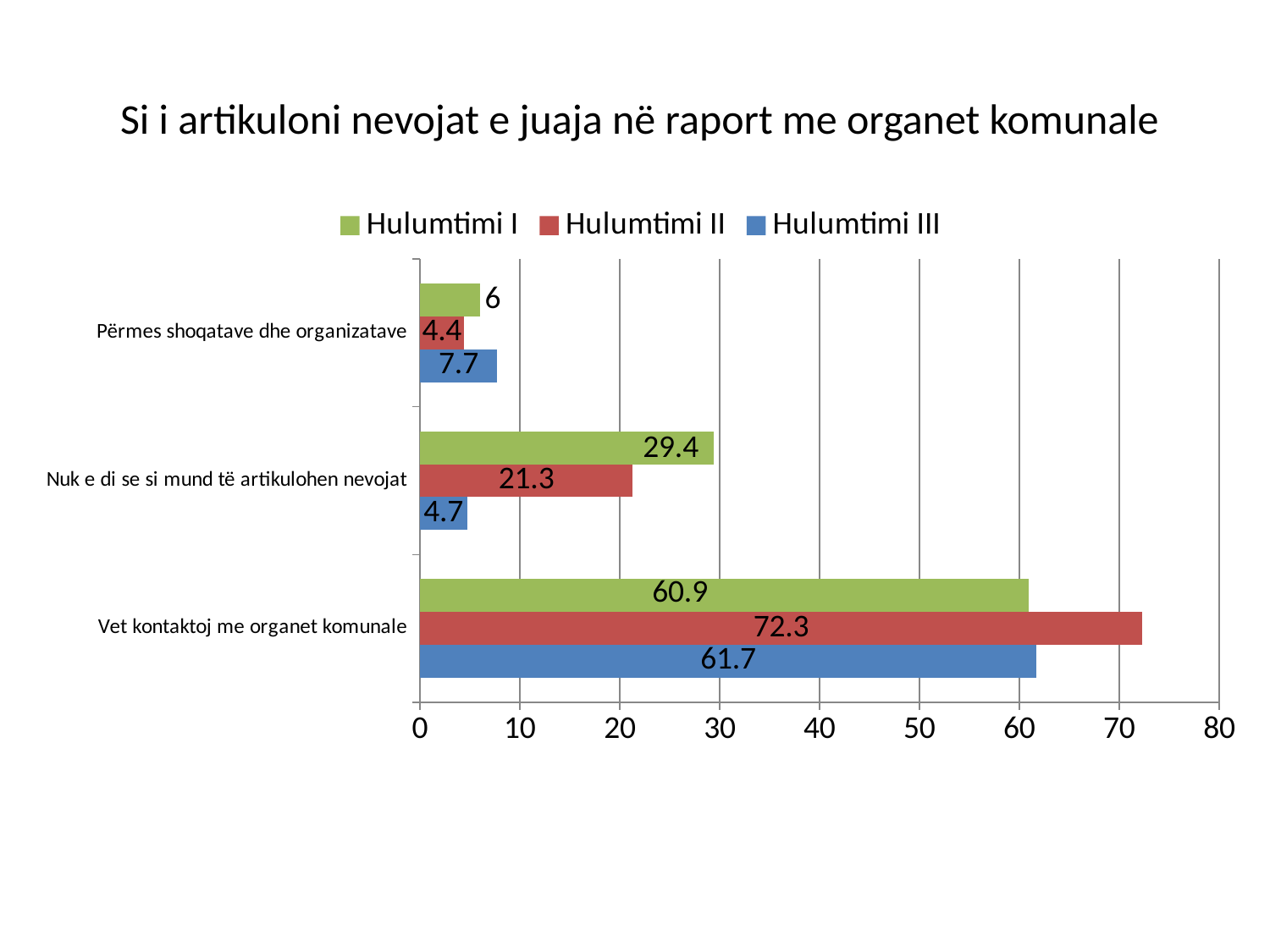
Which series has the highest value in the category 'Vet kontaktoj me organet komunale'? Hulumtimi II What kind of chart is shown on the slide? bar chart Which series has the lowest value in the category 'Përmes shoqatave dhe organizatave'? Hulumtimi II What is the value for Hulumtimi I in the category 'Përmes shoqatave dhe organizatave'? 6 Which is larger in the category 'Vet kontaktoj me organet komunale': Hulumtimi I or Hulumtimi III? Hulumtimi III Is the value for Hulumtimi II in 'Vet kontaktoj me organet komunale' greater or less than 70? greater What is the value for Hulumtimi II in the category 'Vet kontaktoj me organet komunale'? 72.3 What is the difference between Hulumtimi I and Hulumtimi II in the category 'Nuk e di se si mund të artikulohen nevojat'? 8.1 What is the title of the chart? Si i artikuloni nevojat e juaja në raport me organet komunale How many categories are shown on the chart? 3 What is the value for Hulumtimi III in the category 'Nuk e di se si mund të artikulohen nevojat'? 4.7 How many series does the legend list? 3